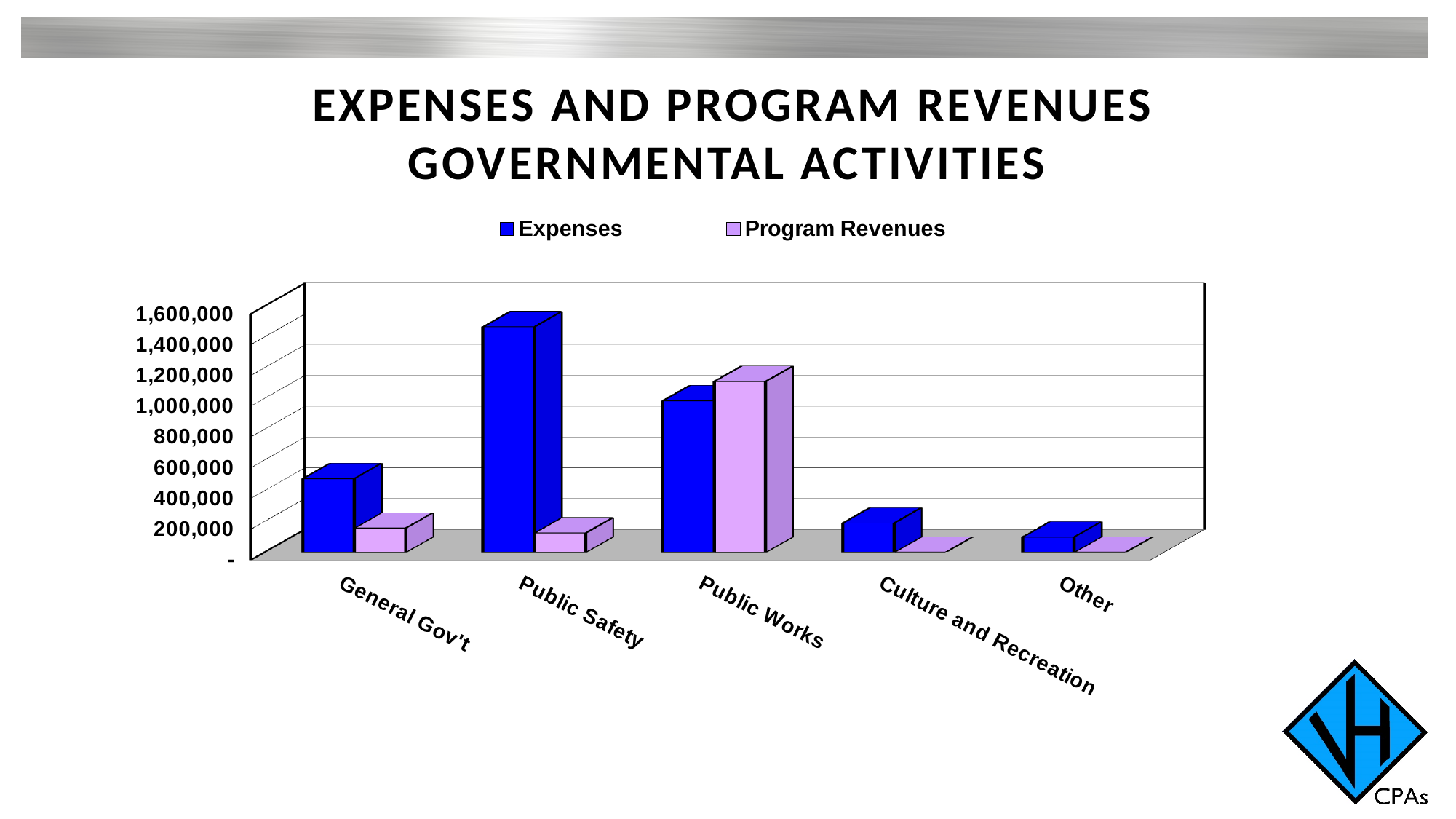
Is the Expenses value for General Gov't greater or less than 800,000? less For Public Works, which is larger: Expenses or Program Revenues? Program Revenues Is the Expenses value for Culture and Recreation greater or less than 400,000? less Which category has the lowest Expenses? Other Is the Expenses value for Public Safety greater or less than 1,200,000? greater How many series does the legend list? 2 How many categories are shown along the x axis? 5 Which category has the highest Expenses? Public Safety What colour represents the Expenses series in the legend? Blue Which is larger: Expenses for Public Safety or Expenses for Public Works? Public Safety Which category has the highest Program Revenues? Public Works What kind of chart is shown on the slide? Bar chart